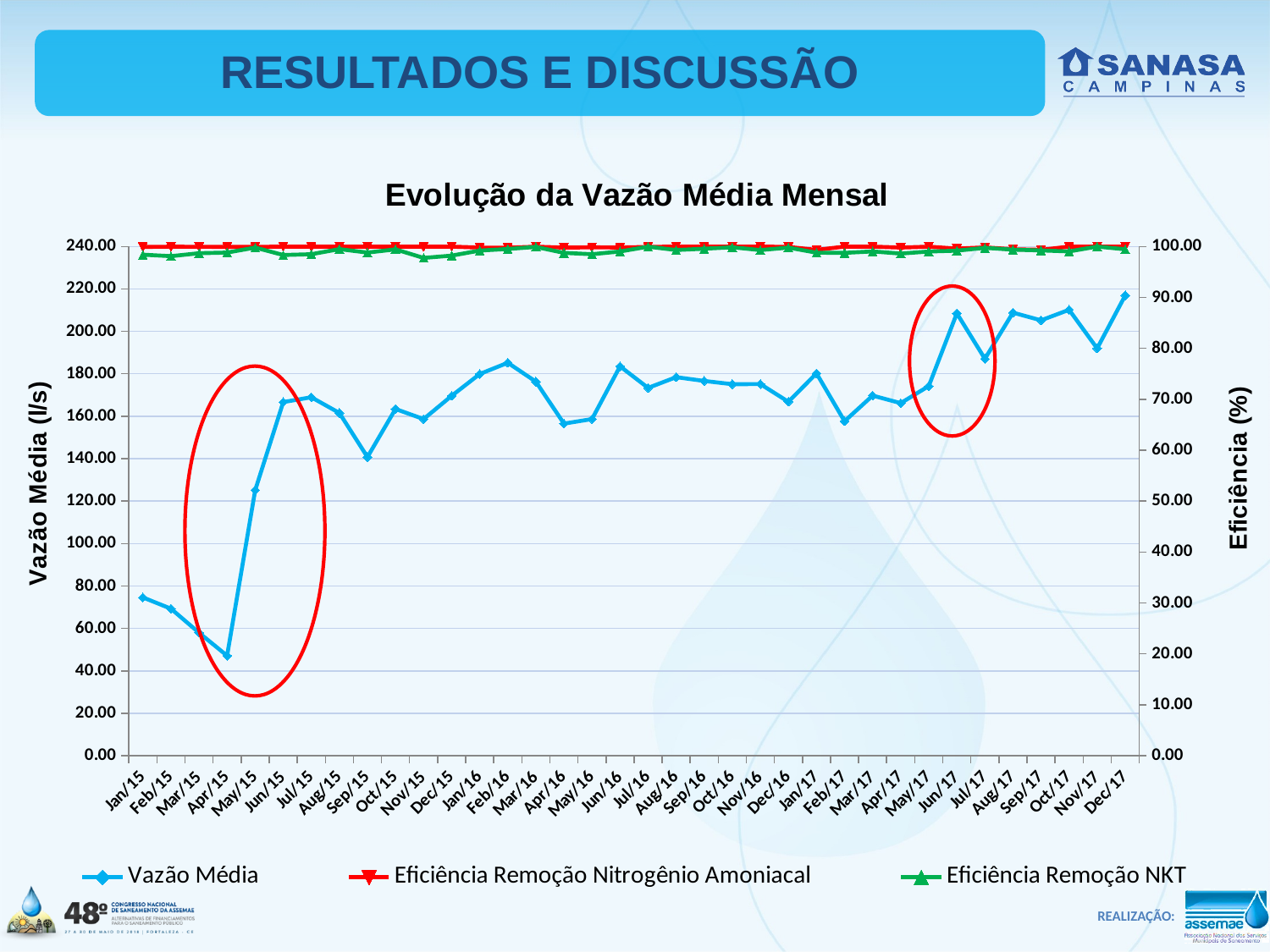
What is the title of the chart? Evolução da Vazão Média Mensal Is the Vazão Média for Sep/15 greater or less than 160.00? less In which month is the Vazão Média at its highest? Dec/17 Which is larger, the Vazão Média for Jun/15 or for Apr/15? Jun/15 How many monthly points are plotted along the x axis? 36 Does the Vazão Média rise or fall from Jan/15 to Apr/15? fall Is the Vazão Média for Apr/15 greater or less than 60.00? less What kind of chart is shown on the slide? line chart How many series does the legend list? 3 Is the Vazão Média for Jun/17 greater or less than 200.00? greater What is the label of the right-hand vertical axis? Eficiência (%) In which month is the Vazão Média at its lowest? Apr/15